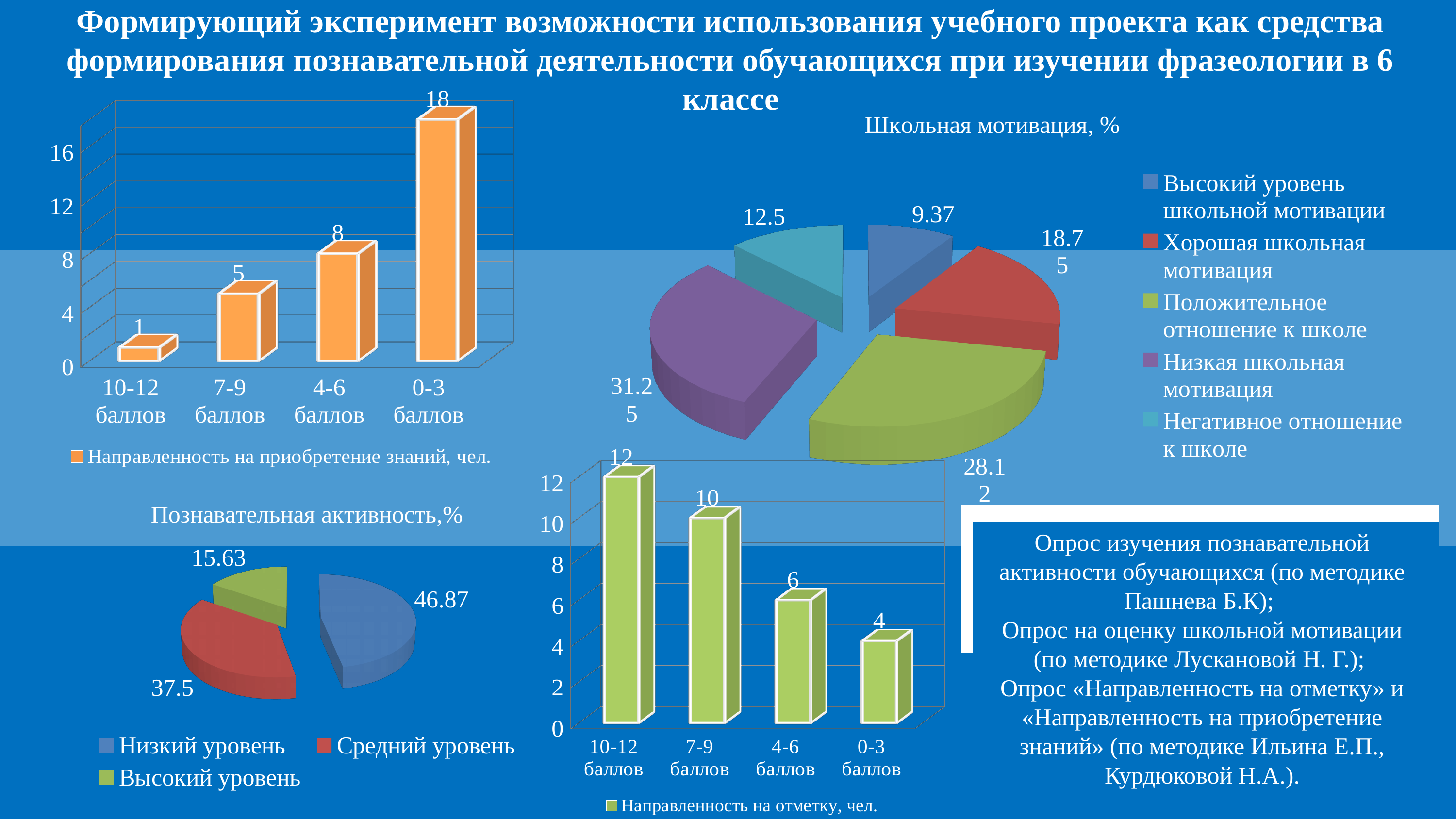
In the bar chart titled 'Направленность на отметку, чел.', what is the value for '7-9 баллов'? 10 In the bar chart titled 'Направленность на отметку, чел.', which category has the highest value? 10-12 баллов In the pie chart titled 'Познавательная активность,%', what is the value for 'Низкий уровень'? 46.87 In the pie chart titled 'Школьная мотивация, %', what is the value for 'Высокий уровень школьной мотивации'? 9.37 In the bar chart titled 'Направленность на приобретение знаний, чел.', which category has the lowest value? 10-12 баллов In the bar chart titled 'Направленность на приобретение знаний, чел.', what is the difference between the values for '4-6 баллов' and '7-9 баллов'? 3 In the bar chart titled 'Направленность на отметку, чел.', how many categories are shown on the x axis? 4 How many entries does the legend of the pie chart titled 'Школьная мотивация, %' list? 5 In the bar chart titled 'Направленность на отметку, чел.', what is the total of the values for '4-6 баллов' and '0-3 баллов'? 10 In the bar chart titled 'Направленность на приобретение знаний, чел.', what is the value for '0-3 баллов'? 18 In the bar chart titled 'Направленность на приобретение знаний, чел.', do the values rise or fall from left to right along the x axis? rise In the pie chart titled 'Познавательная активность,%', which category has the smallest slice? Высокий уровень